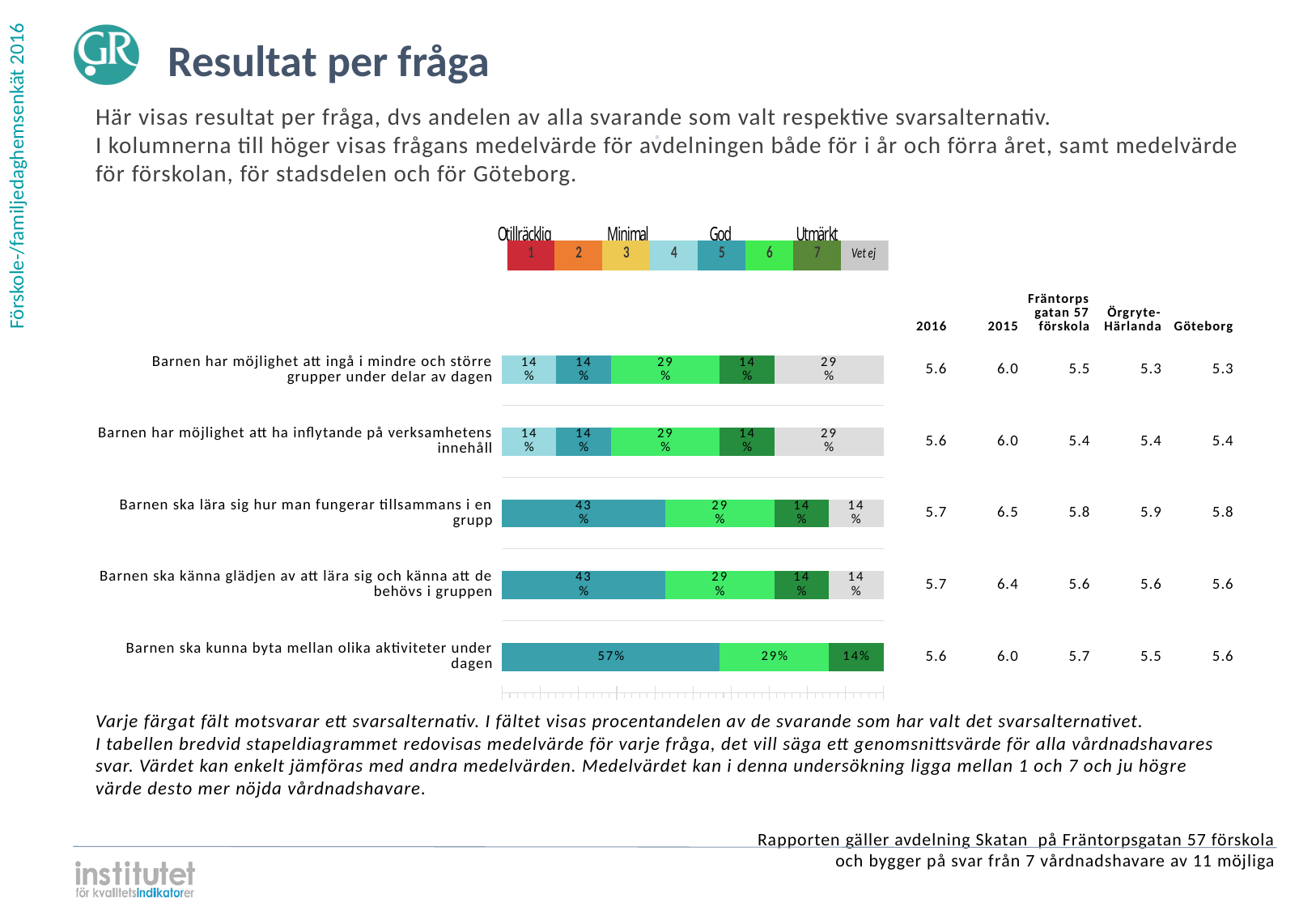
How many response options does the legend above the chart list, including 'Vet ej'? 8 What percentage of respondents chose option 5 for 'Barnen ska kunna byta mellan olika aktiviteter under dagen'? 57% What is the Göteborg mean value for 'Barnen har möjlighet att ingå i mindre och större grupper under delar av dagen'? 5.3 What is the total of all segments in the bar for 'Barnen har möjlighet att ingå i mindre och större grupper under delar av dagen'? 100% What percentage answered 'Vet ej' for 'Barnen har möjlighet att ha inflytande på verksamhetens innehåll'? 29% What kind of chart is shown on the slide? Stacked bar chart Is the option 5 share for 'Barnen ska känna glädjen av att lära sig och känna att de behövs i gruppen' larger or smaller than its option 7 share? Larger How many questions (categories) are plotted in the bar chart? 5 What is the difference between the option 5 share (57%) and the option 6 share (29%) for 'Barnen ska kunna byta mellan olika aktiviteter under dagen'? 28 percentage points What percentage chose option 6 for 'Barnen ska lära sig hur man fungerar tillsammans i en grupp'? 29% What is the 2015 mean value for 'Barnen ska lära sig hur man fungerar tillsammans i en grupp'? 6.5 Which question has the largest single segment in its bar? Barnen ska kunna byta mellan olika aktiviteter under dagen